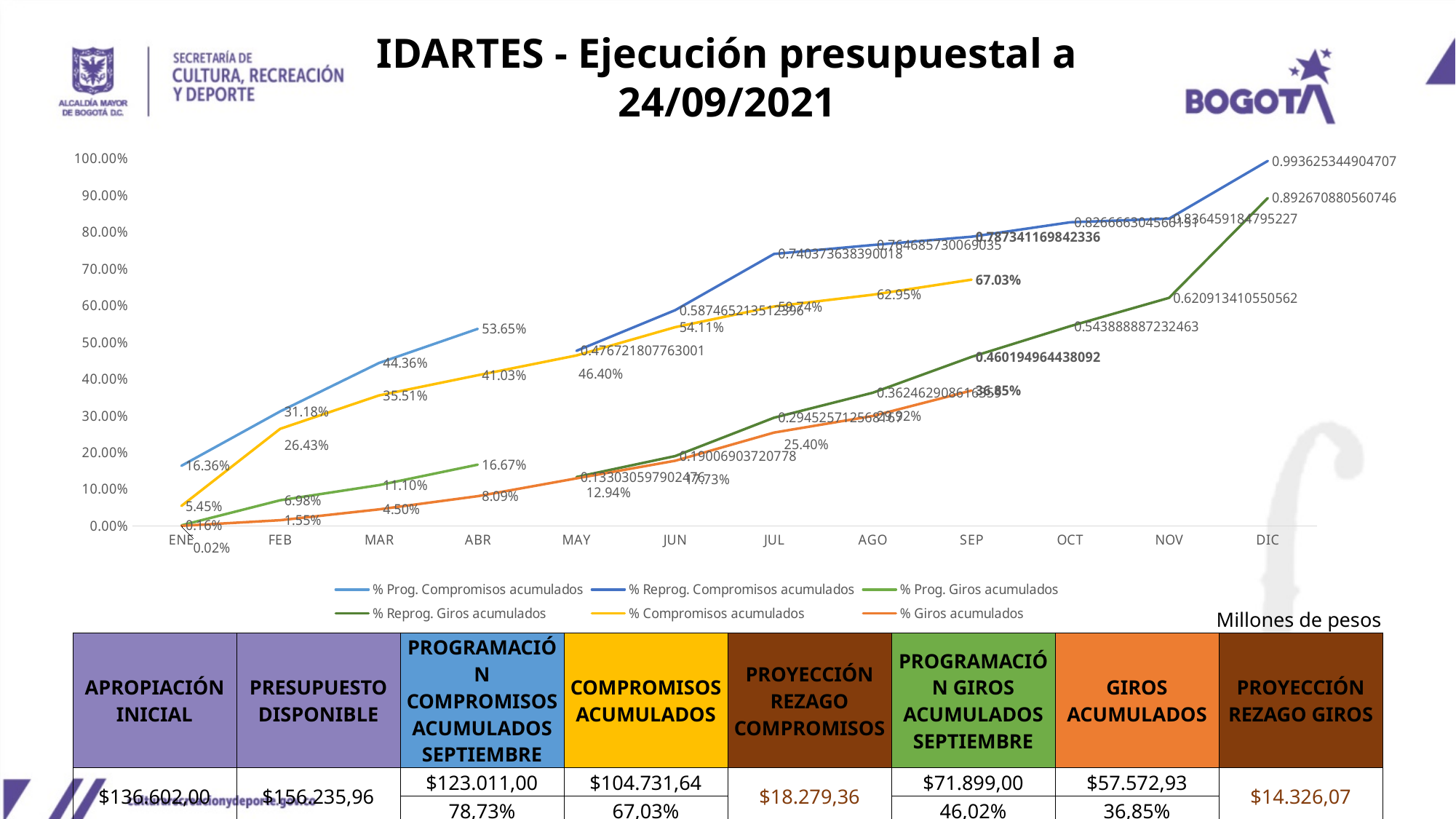
What is the data label for % Reprog. Giros acumulados in DIC? 0.892670880560746 Is the value for % Reprog. Giros acumulados in NOV greater or less than 70%? less How many months are shown on the x axis of the chart? 12 Does % Compromisos acumulados rise or fall from ENE to SEP? rise What is the value of % Prog. Compromisos acumulados in ABR? 53.65% What is the data label for % Reprog. Compromisos acumulados in DIC? 0.993625344904707 How many series does the chart legend list? 6 What type of chart is shown on the slide? line chart In DIC, which is higher: % Reprog. Compromisos acumulados or % Reprog. Giros acumulados? % Reprog. Compromisos acumulados What is the value of % Giros acumulados in SEP? 36.85% What is the difference between % Compromisos acumulados and % Giros acumulados in SEP? 30.18 percentage points What is the value of % Compromisos acumulados in SEP? 67.03%